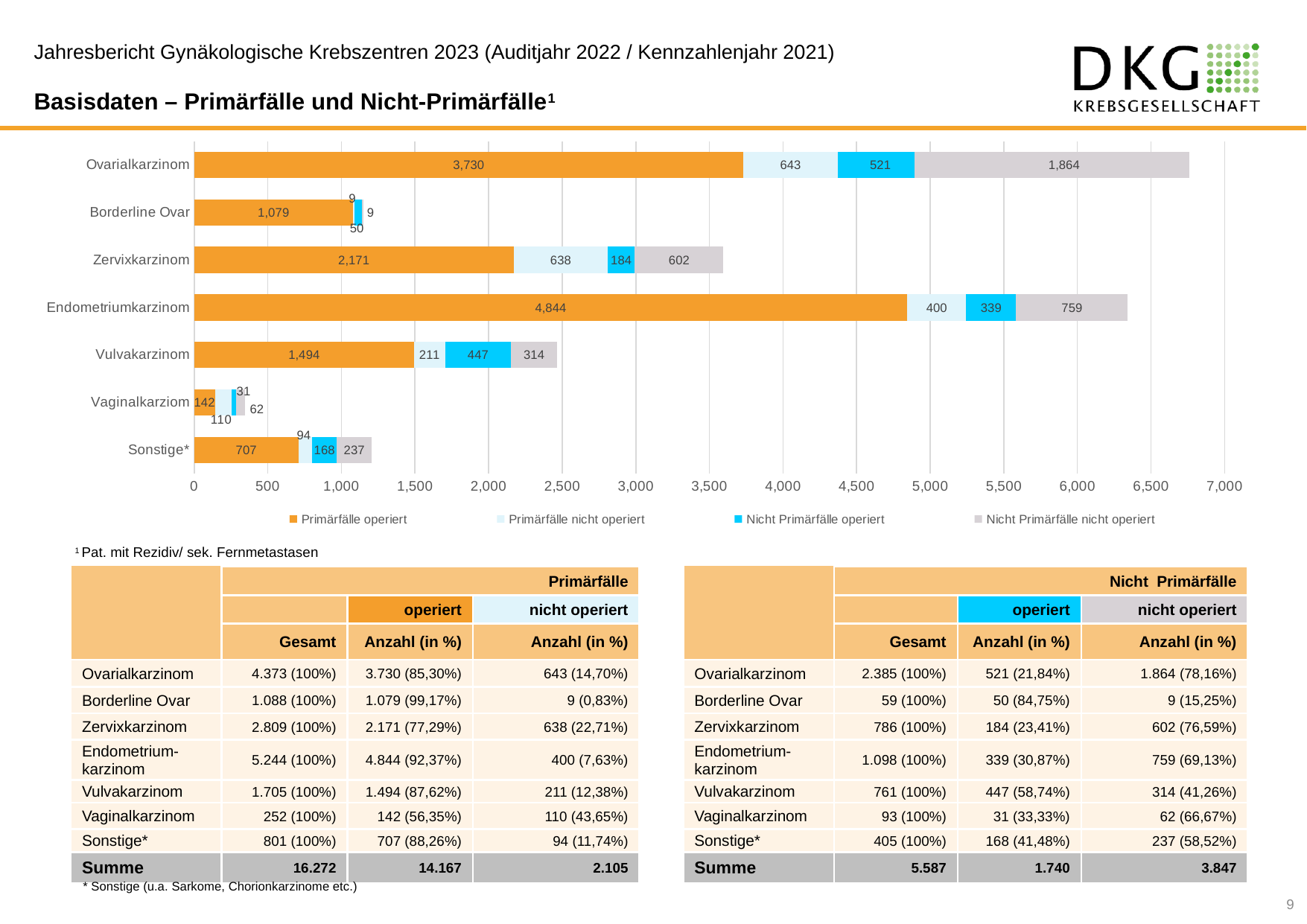
Which category has the highest value for 'Primärfälle operiert' in the chart? Endometriumkarzinom What is the total of the stacked bar for Vulvakarzinom in the chart? 2,466 Which category has the lowest value for 'Primärfälle operiert' in the chart? Vaginalkarziom What is the difference between the 'Primärfälle operiert' values for Ovarialkarzinom and Zervixkarzinom in the chart? 1,559 What is the total of the stacked bar for Zervixkarzinom in the chart? 3,595 Which is larger in the chart: 'Nicht Primärfälle operiert' for Ovarialkarzinom or for Endometriumkarzinom? Ovarialkarzinom How many categories are shown on the y axis of the chart? 7 How many series does the chart legend list? 4 What is the value of 'Nicht Primärfälle nicht operiert' for Ovarialkarzinom in the chart? 1,864 What type of chart is shown on the slide? Stacked bar chart What is the value of 'Primärfälle operiert' for Endometriumkarzinom in the chart? 4,844 What is the value of 'Nicht Primärfälle operiert' for Vulvakarzinom in the chart? 447